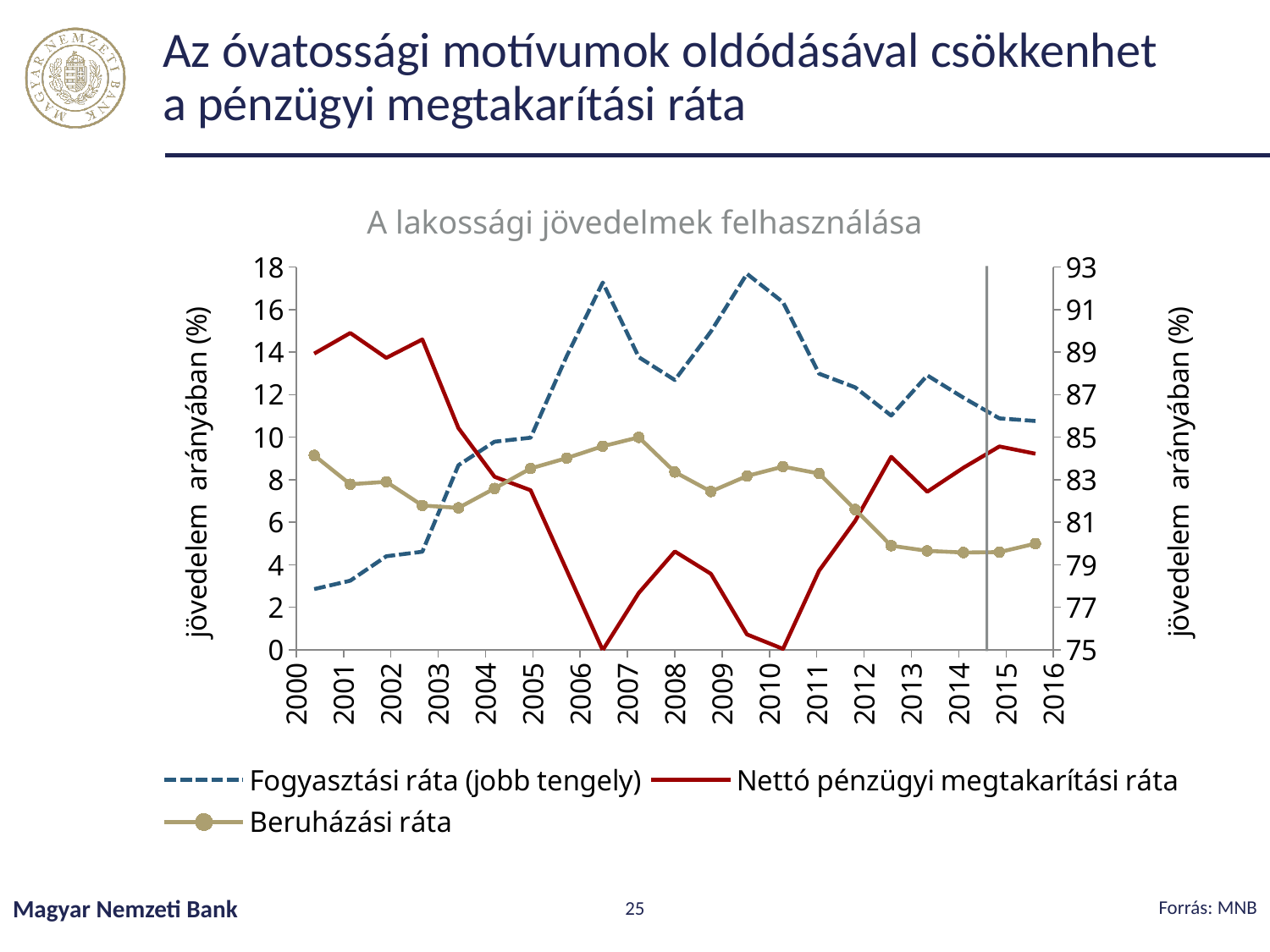
Which series is plotted on the right axis according to the legend? Fogyasztási ráta (jobb tengely) Is the value of Fogyasztási ráta in 2000 (right axis) greater or less than 81? less Is the value of Nettó pénzügyi megtakarítási ráta in 2006 greater or less than 2? less Is the value of Nettó pénzügyi megtakarítási ráta in 2001 greater or less than 12? greater How many year labels are shown on the x axis? 17 Does the Beruházási ráta rise or fall between 2007 and 2014? fall How many series does the legend list? 3 What kind of chart is shown on the slide? line chart What is the title of the chart? A lakossági jövedelmek felhasználása In 2013, which is larger: Nettó pénzügyi megtakarítási ráta or Beruházási ráta? Nettó pénzügyi megtakarítási ráta